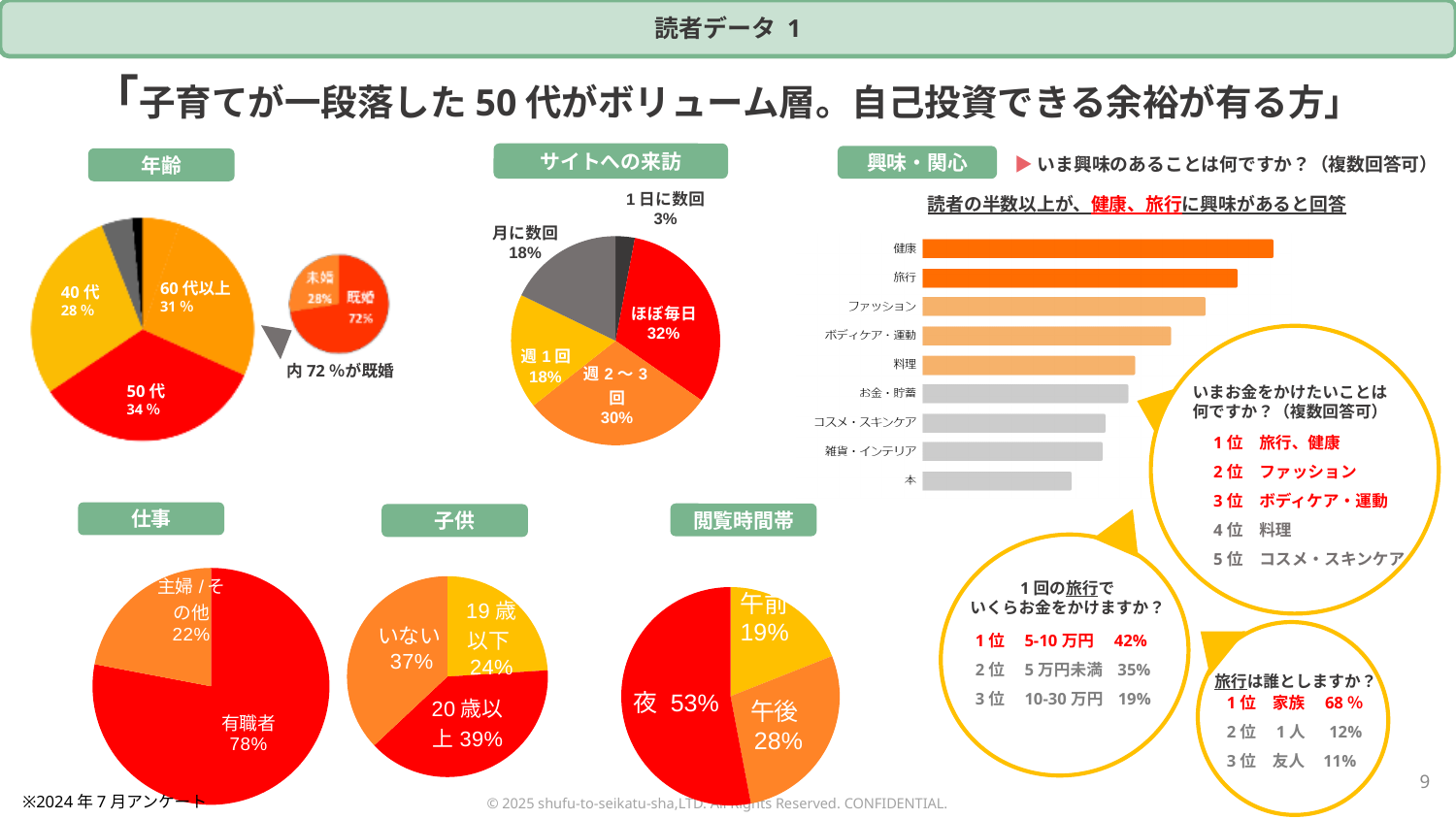
In the 年齢 pie chart, what share is 50 代? 34 % In the 興味・関心 chart, how many categories are listed? 9 In the 閲覧時間帯 pie chart, which is larger, 午前 or 午後? 午後 In the 年齢 pie chart, which labelled age group has the largest share? 50 代 In the 興味・関心 chart, which category has the longest bar? 健康 In the サイトへの来訪 pie chart, how many categories are shown? 5 What kind of chart is the 興味・関心 chart? bar chart In the small 未婚/既婚 pie chart next to the 年齢 chart, what share is 既婚? 72% In the サイトへの来訪 pie chart, which category has the smallest share? 1 日に数回 In the 仕事 pie chart, what share is 有職者? 78% In the 年齢 pie chart, what is the difference between the 50 代 share and the 40 代 share? 6 % In the サイトへの来訪 pie chart, what share is ほぼ毎日? 32%